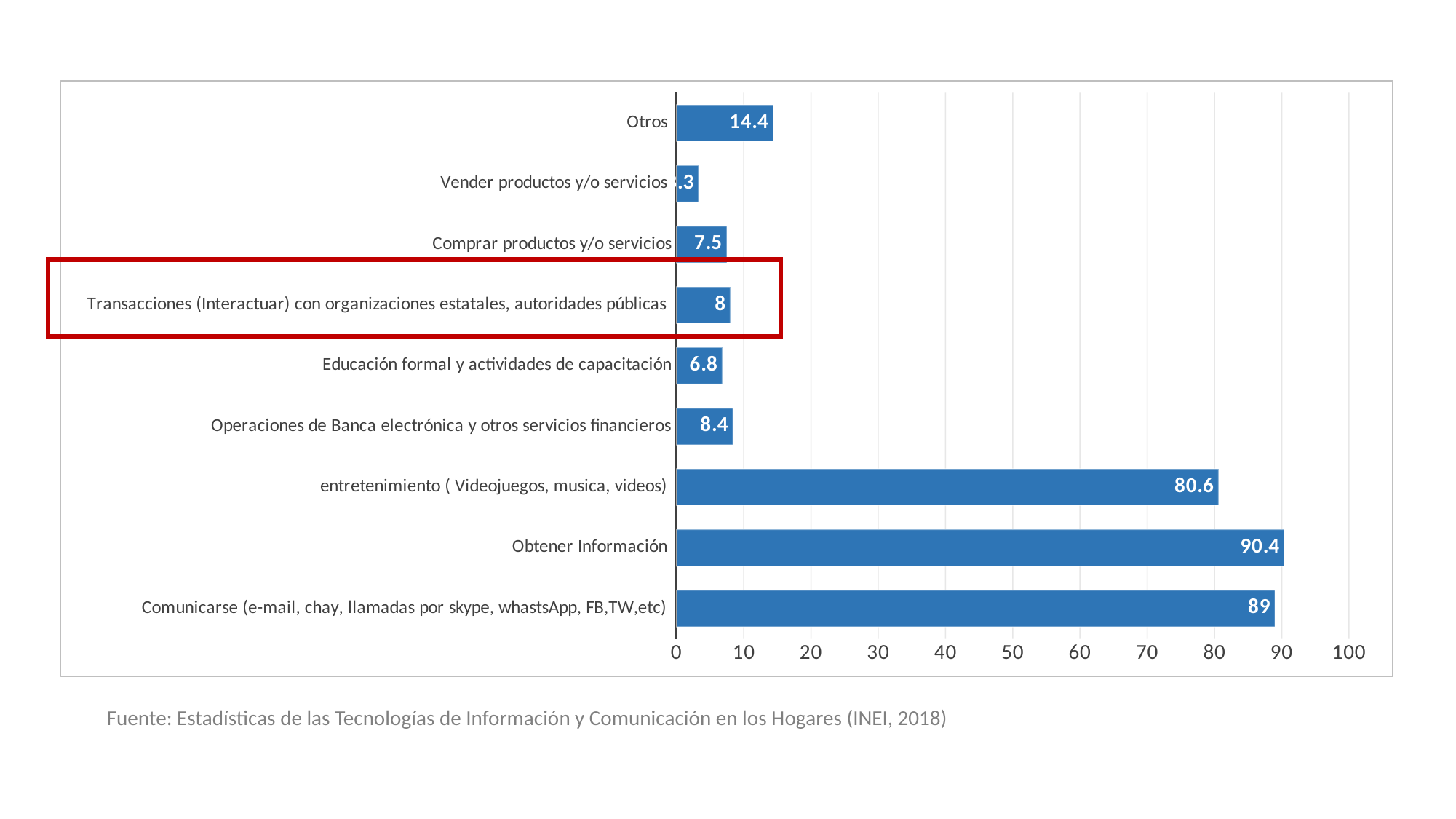
What is the value for entretenimiento (Videojuegos, musica, videos)? 80.6 What is the difference between the values for Obtener Información and Comunicarse (e-mail, chay, llamadas por skype, whastsApp, FB,TW,etc)? 1.4 What is the value for Obtener Información? 90.4 Which category has the lowest value? Vender productos y/o servicios What is the value for Otros? 14.4 Which category is highlighted with a red box on the slide? Transacciones (Interactuar) con organizaciones estatales, autoridades públicas Which is larger, the value for Operaciones de Banca electrónica y otros servicios financieros or the value for Educación formal y actividades de capacitación? Operaciones de Banca electrónica y otros servicios financieros What is the value for Transacciones (Interactuar) con organizaciones estatales, autoridades públicas? 8 How many categories are plotted in the chart? 9 Is the value for Vender productos y/o servicios greater or less than 10? less Which category has the highest value? Obtener Información What type of chart is shown on the slide? Bar chart